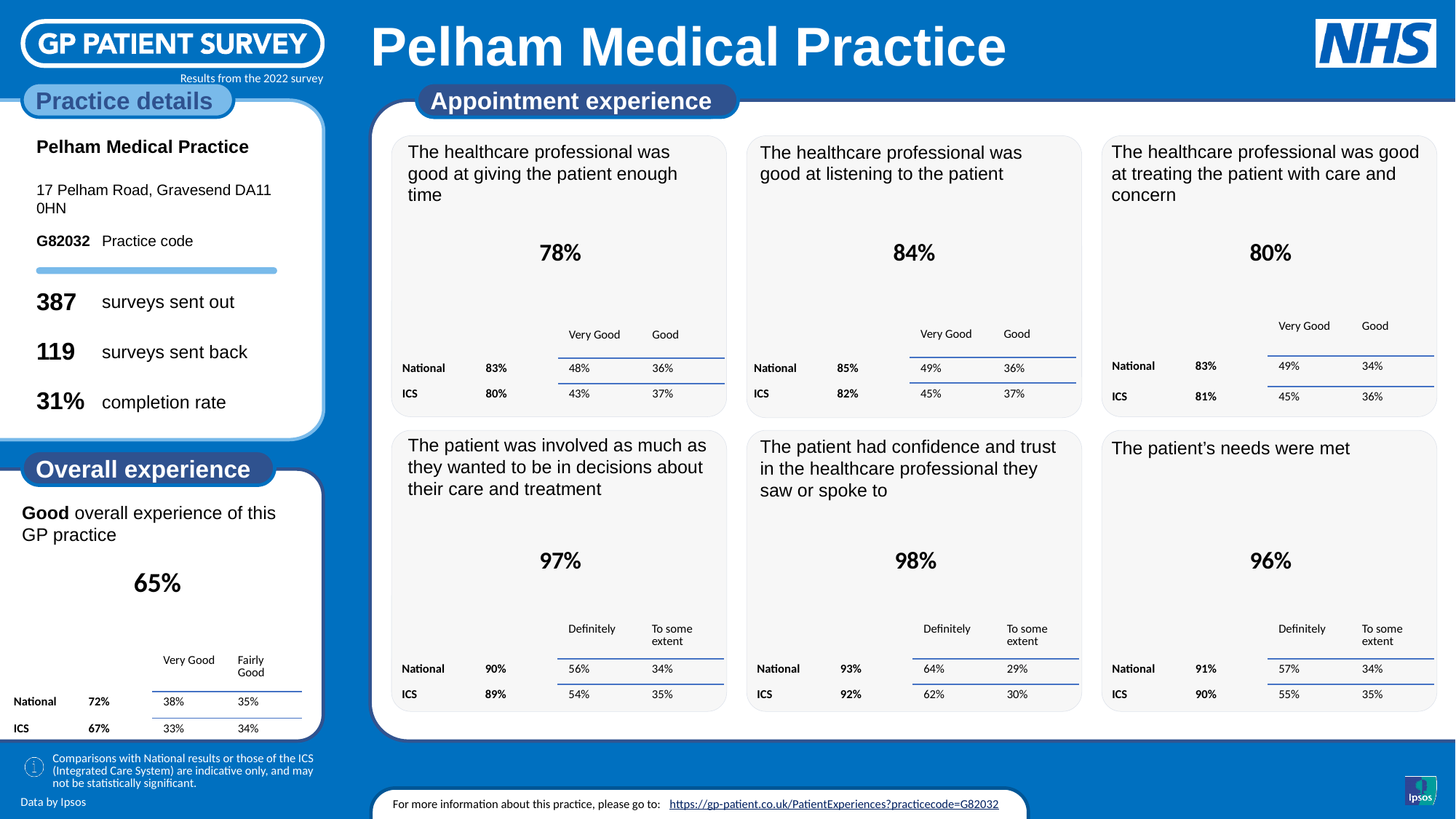
In the panel 'The patient's needs were met', what is the difference between the practice figure (96%) and the ICS figure (90%)? 6 percentage points In the panel 'The patient was involved as much as they wanted to be in decisions about their care and treatment', what is the practice's percentage? 97% In the panel 'The healthcare professional was good at listening to the patient', what is the ICS 'Good' percentage? 37% Across the six 'Appointment experience' panels, which question has the highest practice percentage? The patient had confidence and trust in the healthcare professional they saw or spoke to (98%) In the 'Overall experience' panel, what is the National figure for good overall experience? 72% In the 'Overall experience' panel, what is the difference between the National figure (72%) and the practice figure (65%)? 7 percentage points In the panel 'The healthcare professional was good at giving the patient enough time', what is the practice's percentage? 78% In the 'Overall experience' panel, what is the ICS 'Very Good' percentage? 33% In the 'Overall experience' panel, what percentage of patients reported a good overall experience of this GP practice? 65% Across the six 'Appointment experience' panels, which question has the lowest practice percentage? The healthcare professional was good at giving the patient enough time (78%) In the panel 'The healthcare professional was good at treating the patient with care and concern', which is larger: the National figure or the ICS figure? National (83%) In the panel 'The patient had confidence and trust in the healthcare professional they saw or spoke to', what is the National 'Definitely' percentage? 64%